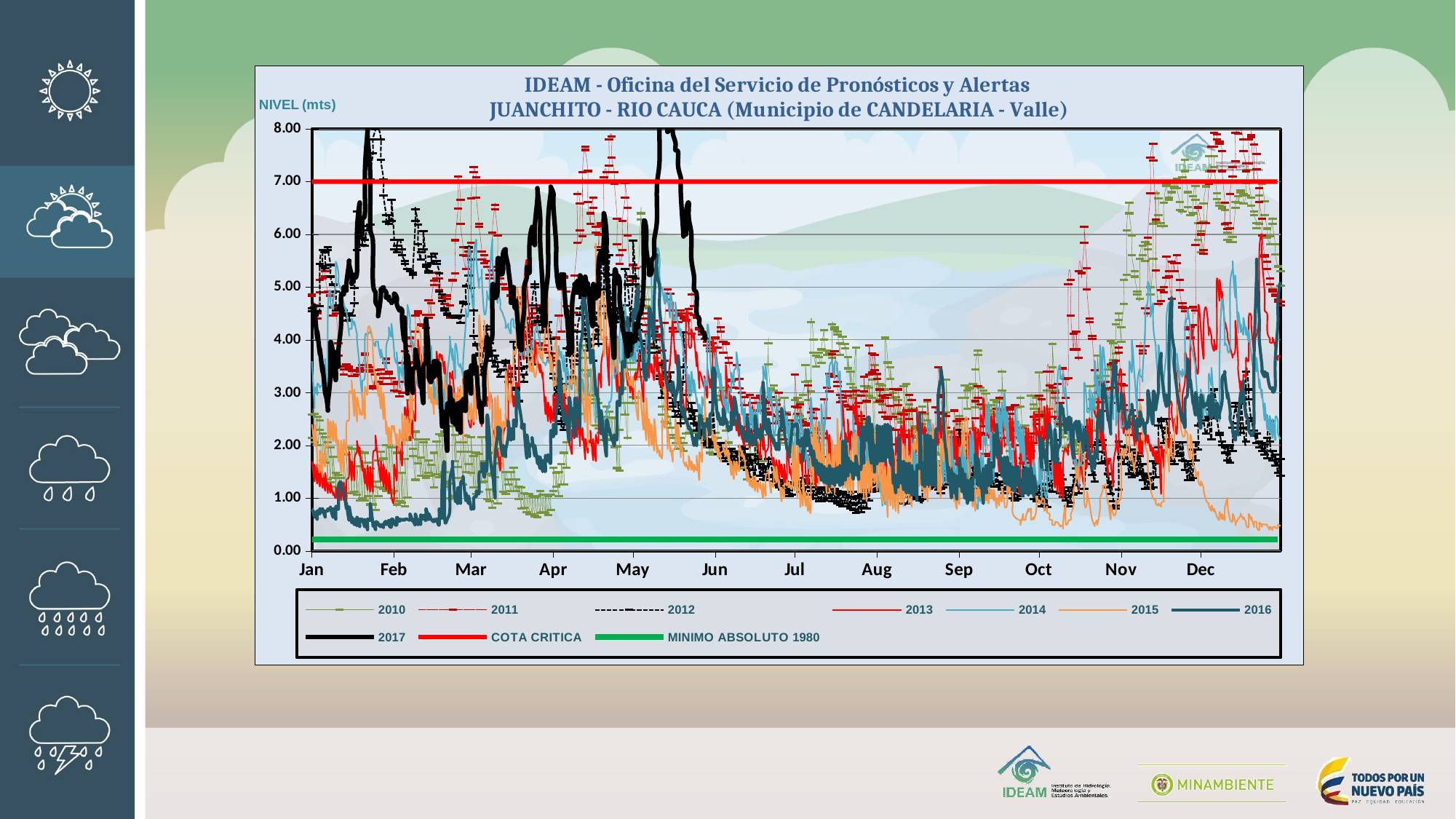
Is the value of the 2015 series in late December greater or less than 1.00? less At what level (in mts) is the COTA CRITICA line drawn? 7.00 Is the MINIMO ABSOLUTO 1980 line greater or less than 1.00? less Does the 2015 series rise or fall from October to December? fall What kind of chart is shown on the slide? line chart In December, which series is higher: 2010 or 2015? 2010 Is the peak value of the 2017 series in early May greater or less than 7.00? greater What is the label of the y axis of the chart? NIVEL (mts) Which station and river does the chart title name? JUANCHITO - RIO CAUCA How many entries does the chart legend list? 10 Which year's series reaches the highest level in May? 2017 How many months are labelled along the x axis of the chart? 12